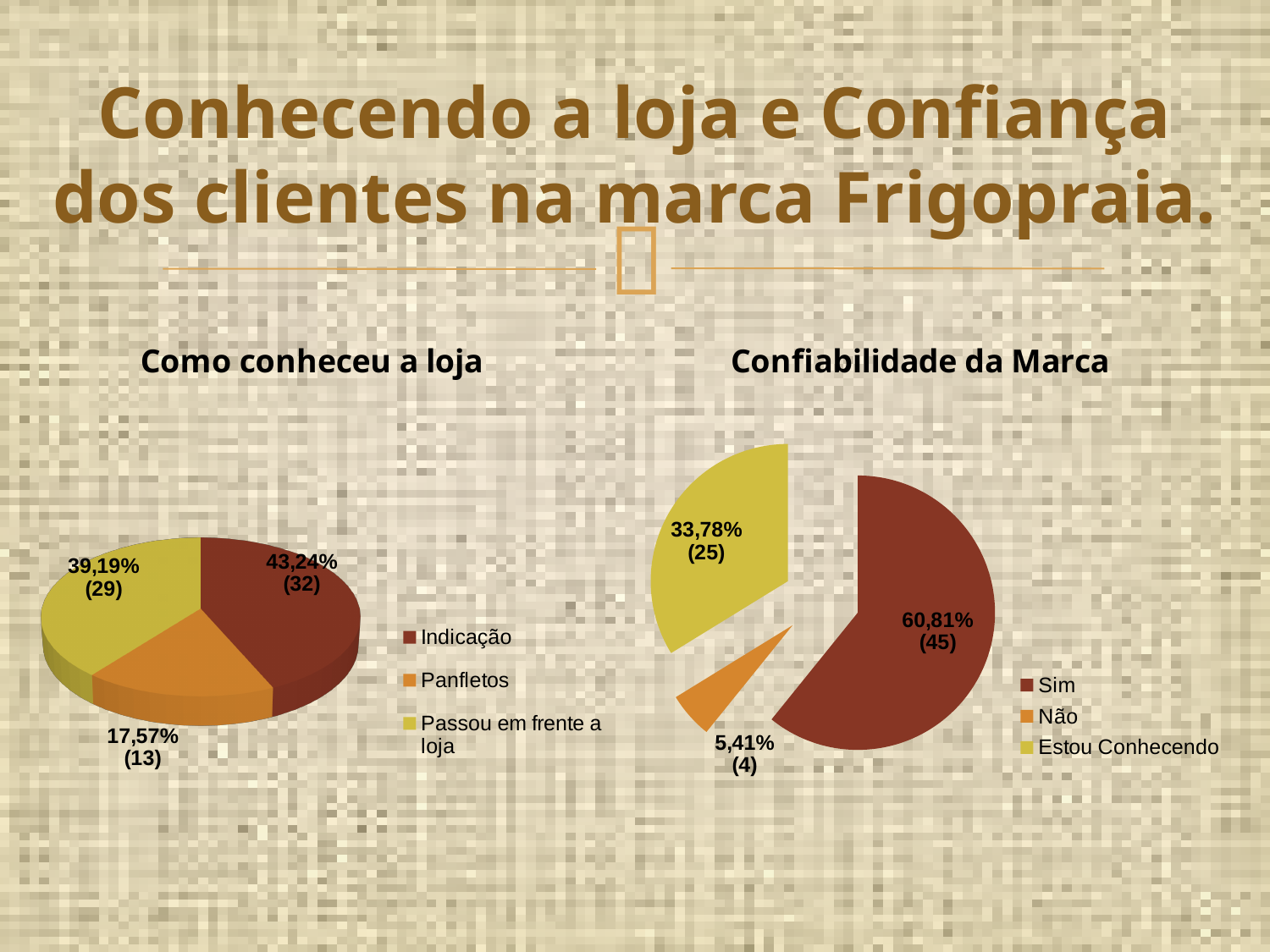
In the 'Confiabilidade da Marca' chart, which category has the smallest share? Não What type of chart is 'Confiabilidade da Marca'? Pie chart In the 'Como conheceu a loja' chart, which category has the smallest share? Panfletos In the 'Como conheceu a loja' chart, what is the difference in respondent counts between Indicação and Passou em frente a loja? 3 In the 'Confiabilidade da Marca' chart, which is larger: Sim or Estou Conhecendo? Sim In the 'Confiabilidade da Marca' chart, what is the difference in respondent counts between Sim and Estou Conhecendo? 20 In the 'Como conheceu a loja' chart, what percentage is shown for Indicação? 43,24% In the 'Confiabilidade da Marca' chart, how many respondents answered Não? 4 In the 'Confiabilidade da Marca' chart, what percentage is shown for Sim? 60,81% In the 'Como conheceu a loja' chart, how many respondents are shown for Panfletos? 13 In the 'Como conheceu a loja' chart, how many categories does the legend list? 3 In the 'Como conheceu a loja' chart, which category has the largest share? Indicação